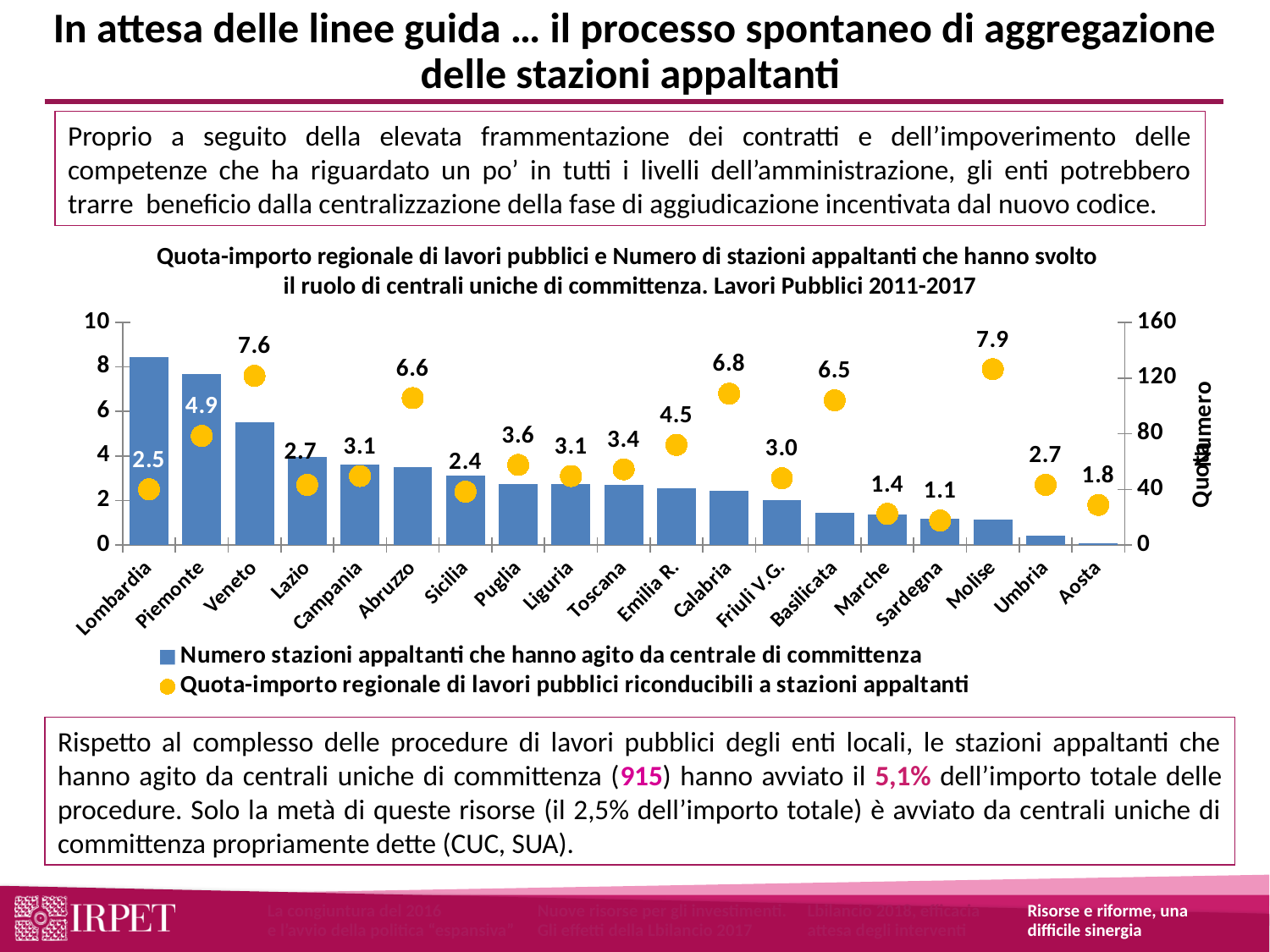
What is the Quota-importo regionale value shown for Molise? 7.9 What is the Quota-importo regionale value shown for Emilia R.? 4.5 Which has a larger Quota-importo value, Abruzzo or Sicilia? Abruzzo How many series does the legend list? 2 Which region has the highest Quota-importo regionale value? Molise What is the difference between the Quota-importo values of Veneto and Lombardia? 5.1 Do the bars for Numero stazioni appaltanti rise or fall from left to right along the x axis? fall Which region has the tallest bar for Numero stazioni appaltanti? Lombardia What is the Quota-importo regionale value shown for Lombardia? 2.5 Is the Numero stazioni appaltanti bar for Lombardia greater or less than 120 on the right axis? greater Which region has the lowest Quota-importo regionale value? Sardegna How many regions are shown on the x axis? 19